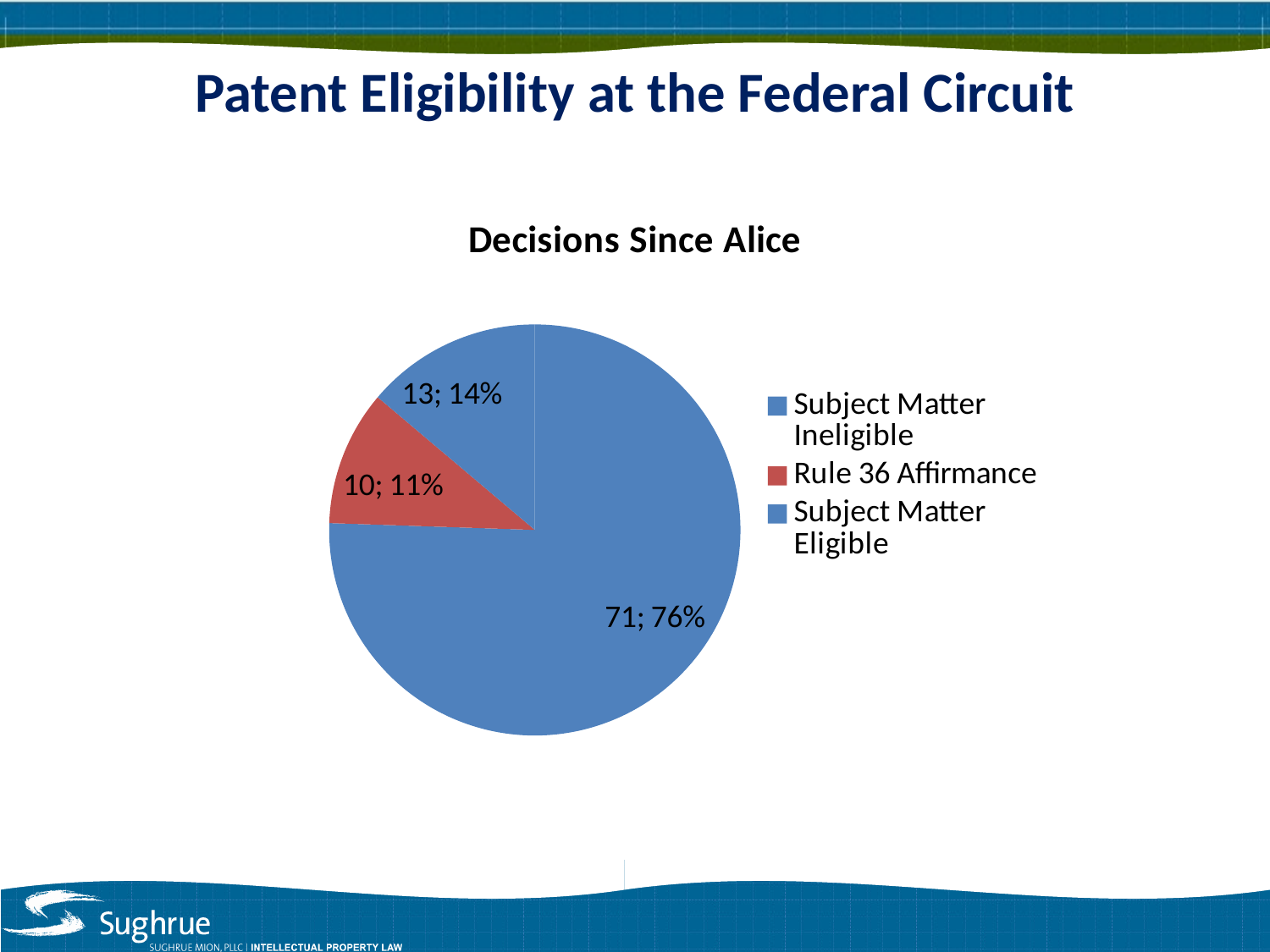
What share of the pie does the Subject Matter Ineligible slice represent? 76% What count and percentage are shown for the Rule 36 Affirmance slice? 10; 11% Which category has the largest slice of the pie? Subject Matter Ineligible Which category has the smallest slice of the pie? Rule 36 Affirmance What is the total count across all three slices of the pie? 94 What is the difference in count between the Subject Matter Ineligible slice and the Subject Matter Eligible slice? 58 How many entries does the legend of the pie chart list? 3 What count and percentage are shown for the Subject Matter Eligible slice? 13; 14% What is the title of the pie chart? Decisions Since Alice What type of chart is shown on the slide? pie chart What count and percentage are shown for the Subject Matter Ineligible slice? 71; 76% How many slices does the pie chart have? 3